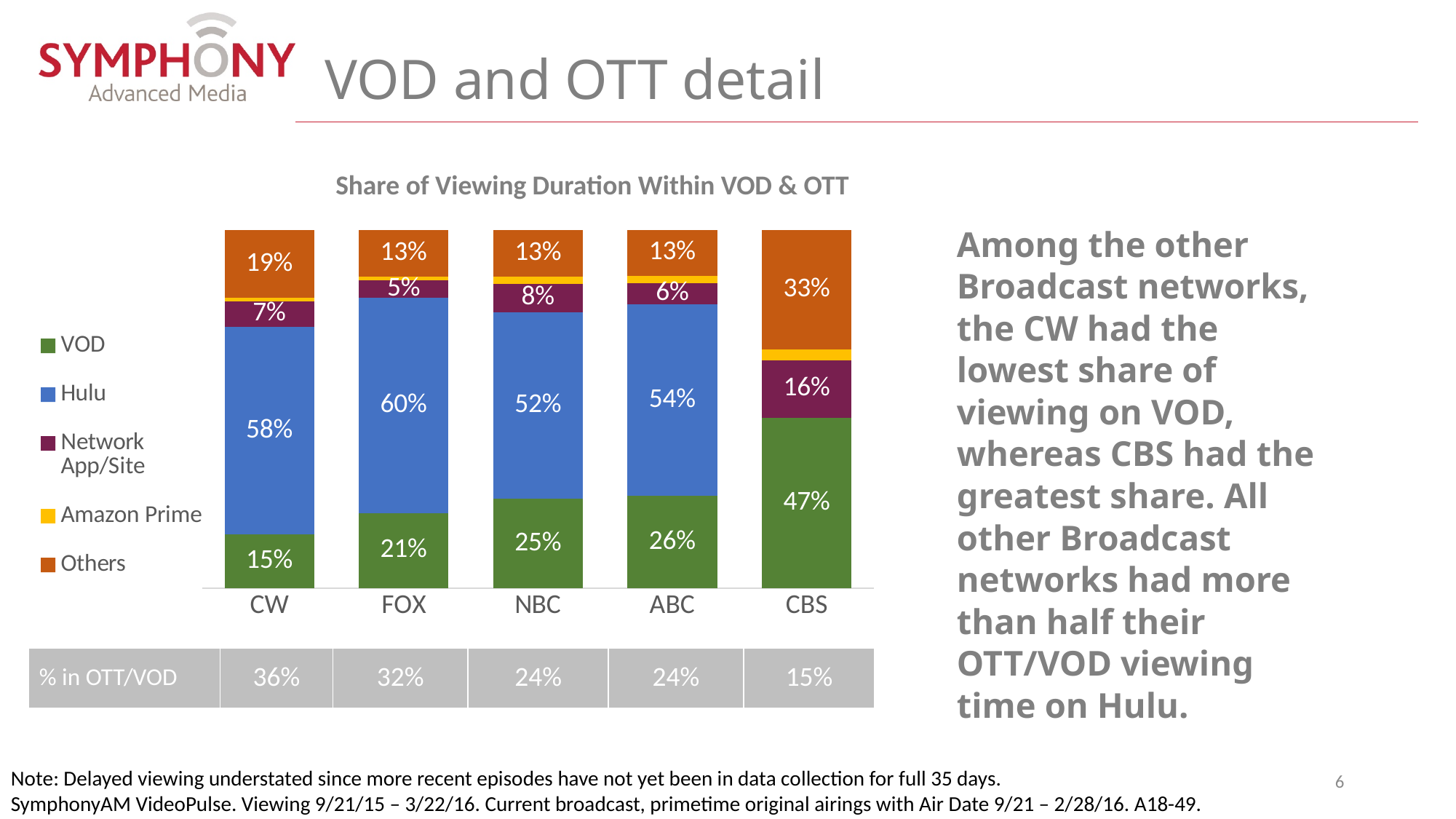
What is the title of the chart? Share of Viewing Duration Within VOD & OTT How many networks are shown on the x axis of the chart? 5 What is the Hulu share for FOX? 60% What type of chart is shown on the slide? stacked bar chart Which network has the lowest VOD share? CW Which is larger, the Hulu share for NBC or the Hulu share for ABC? ABC What is the VOD share for CBS? 47% What is the Network App/Site share for NBC? 8% Which network has the highest Others share? CBS What is the Others share for CW? 19% How many series does the legend list? 5 What is the difference between the VOD share for ABC and the VOD share for CW? 11%